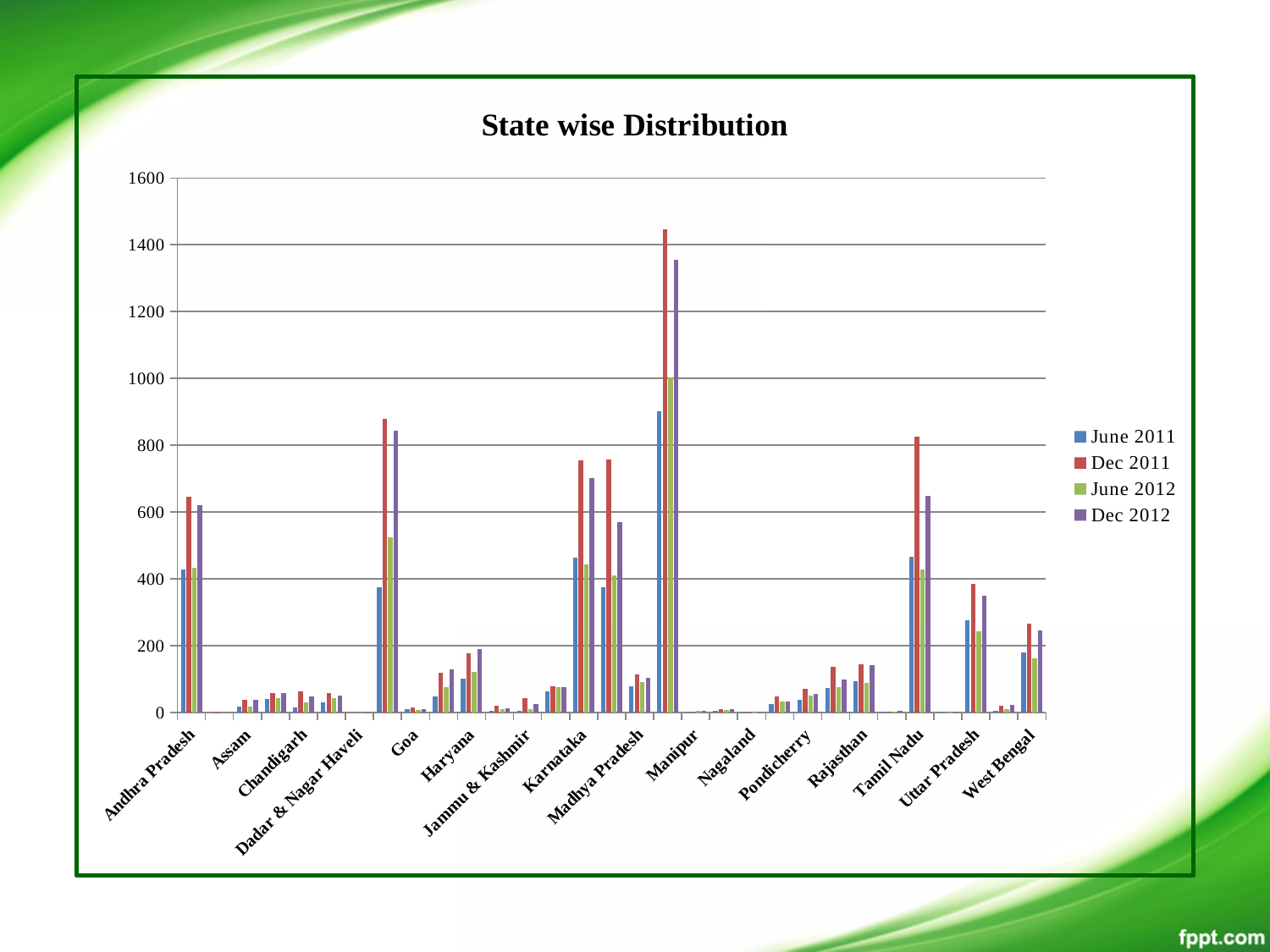
What is the title of the chart? State wise Distribution Which series has the highest value for Tamil Nadu? Dec 2011 Which is larger for Karnataka: the June 2011 value or the Dec 2011 value? Dec 2011 Which series is listed last in the legend? Dec 2012 Is the Dec 2012 value for Haryana greater or less than 400? less How many state labels are shown on the x axis? 16 Is the Dec 2011 value for Uttar Pradesh greater or less than 600? less How many series does the legend list? 4 Is the Dec 2011 value for Karnataka greater or less than 600? greater Which state has the larger Dec 2011 value: Karnataka or Uttar Pradesh? Karnataka What kind of chart is shown on the slide? bar chart